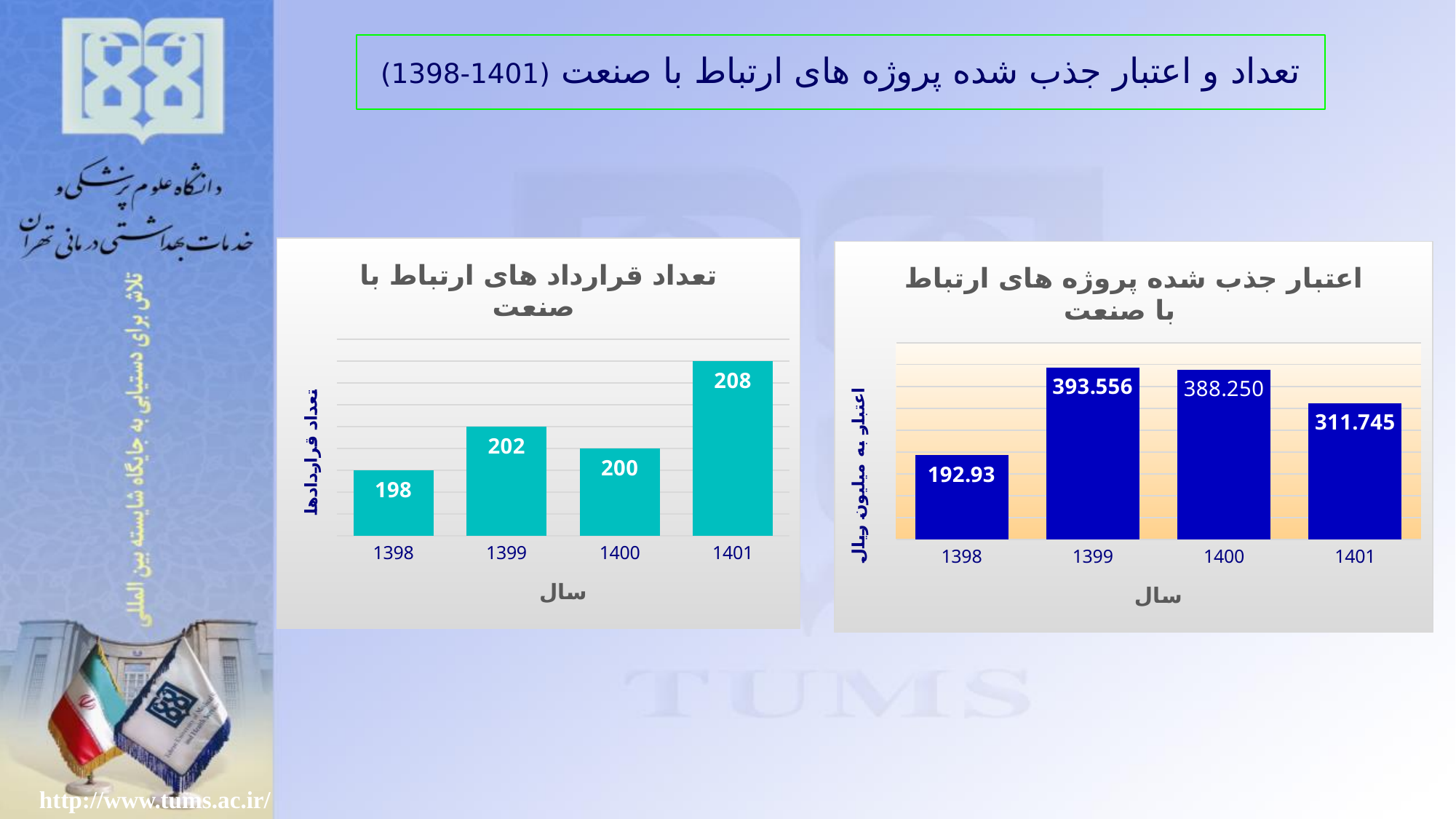
What type of chart is the left chart (تعداد قرارداد های ارتباط با صنعت)? Bar chart In the right chart (اعتبار جذب شده پروژه های ارتباط با صنعت), what is the value for 1398? 192.93 In the left chart (تعداد قرارداد های ارتباط با صنعت), which year has the highest value? 1401 In the right chart (اعتبار جذب شده پروژه های ارتباط با صنعت), which year has the lowest value? 1398 In the left chart (تعداد قرارداد های ارتباط با صنعت), what is the value for 1398? 198 In the right chart (اعتبار جذب شده پروژه های ارتباط با صنعت), which is larger, the value for 1400 or the value for 1401? 1400 In the left chart (تعداد قرارداد های ارتباط با صنعت), which year has the lowest value? 1398 In the left chart (تعداد قرارداد های ارتباط با صنعت), which is larger, the value for 1399 or the value for 1400? 1399 In the left chart (تعداد قرارداد های ارتباط با صنعت), what is the difference between the values for 1401 and 1398? 10 How many years are shown on the x axis of the right chart (اعتبار جذب شده پروژه های ارتباط با صنعت)? 4 In the left chart (تعداد قرارداد های ارتباط با صنعت), what is the value for 1401? 208 In the right chart (اعتبار جذب شده پروژه های ارتباط با صنعت), what is the value for 1399? 393.556